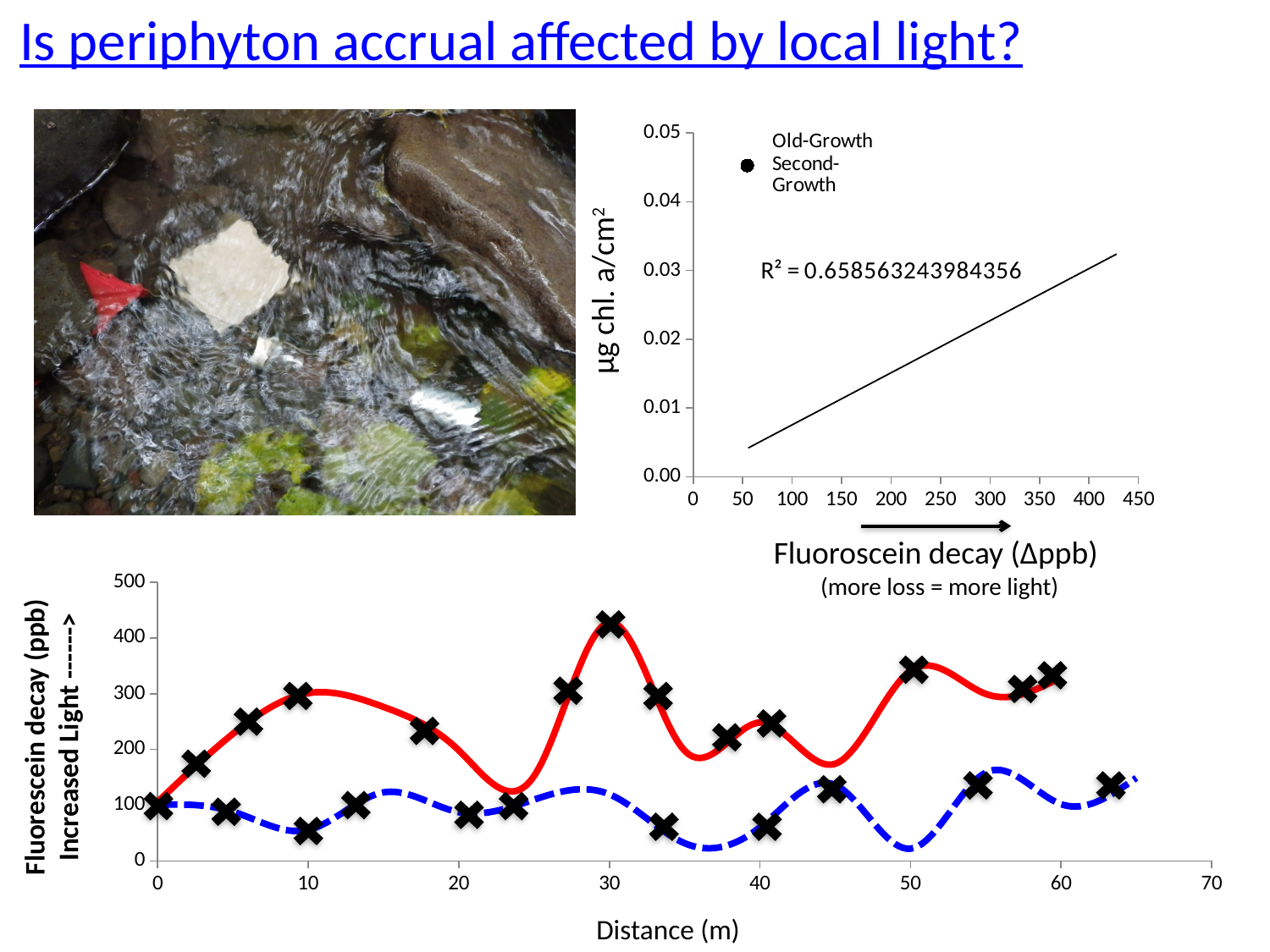
What is the x-axis label of the bottom chart? Distance (m) In the bottom chart, is the blue dashed line's value at about 10 m greater or less than 100? less In the bottom chart, is the peak value of the red solid line (at about 30 m) greater or less than 400? greater In the top-right chart, what R² value is printed on the chart? R² = 0.658563243984356 In the bottom chart, is the red solid line's value at about 50 m greater or less than 300? greater What is the highest tick value shown on the x-axis of the top-right chart? 450 How many series does the legend of the top-right chart list? 2 In the bottom chart, at about 30 m, which line has the larger value, the red solid line or the blue dashed line? red solid line What kind of chart is the bottom chart? line chart In the top-right chart, does the trendline rise or fall as fluoroscein decay increases? rise What is the x-axis label of the top-right chart? Fluoroscein decay (Δppb)